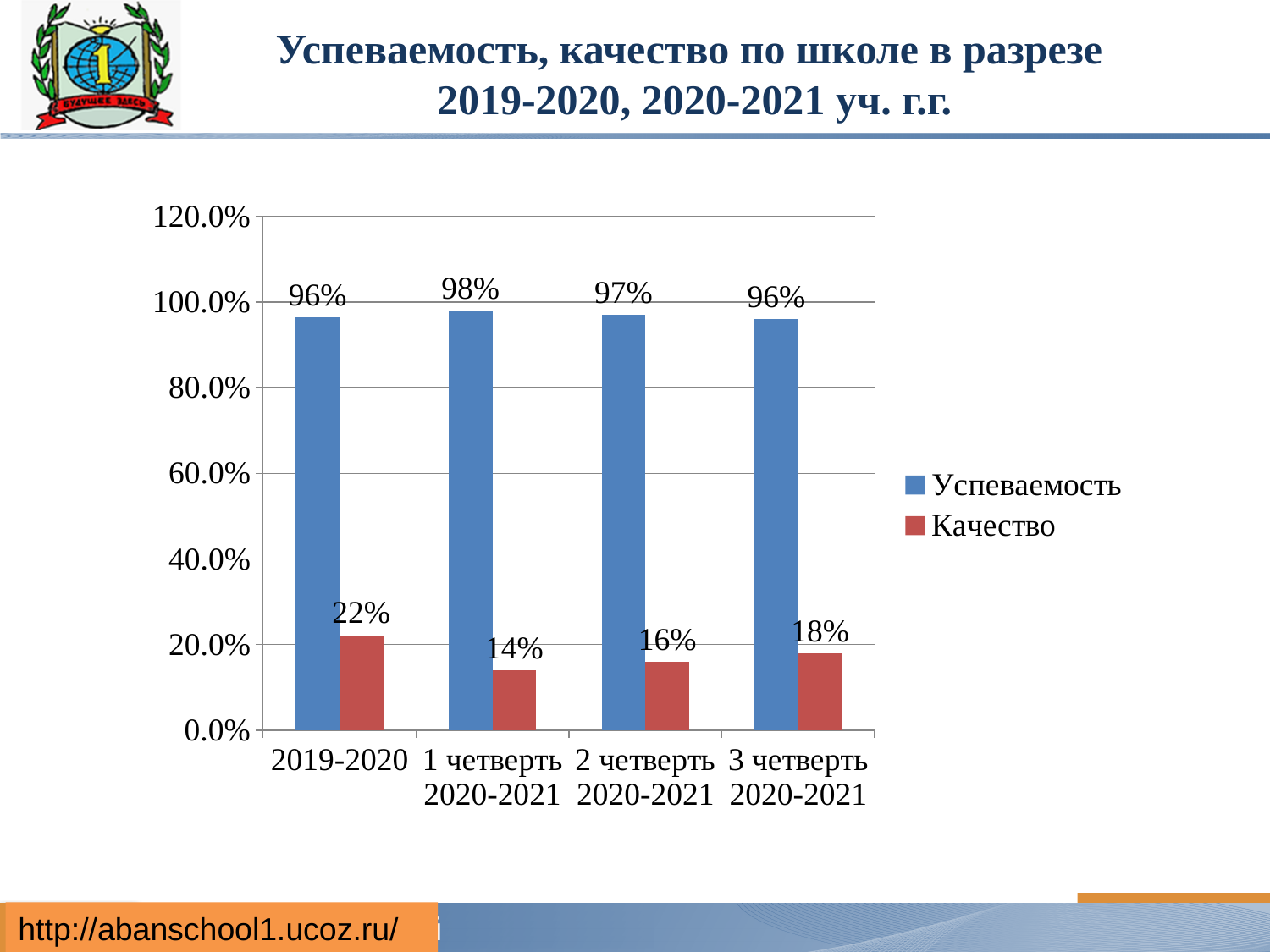
How many series does the legend list? 2 What kind of chart is shown on the slide? bar chart Do the Качество values rise or fall across the three quarters of 2020-2021? rise What is the value of Успеваемость for 2019-2020? 96% Which category has the highest Успеваемость value? 1 четверть 2020-2021 What is the value of Качество for 1 четверть 2020-2021? 14% Which is larger: Качество for 2 четверть 2020-2021 or Качество for 3 четверть 2020-2021? 3 четверть 2020-2021 How many categories are shown on the x axis? 4 What is the value of Успеваемость for 2 четверть 2020-2021? 97% What is the value of Качество for 3 четверть 2020-2021? 18% What is the difference between the Качество values for 2019-2020 and 1 четверть 2020-2021? 8% Which category has the lowest Качество value? 1 четверть 2020-2021